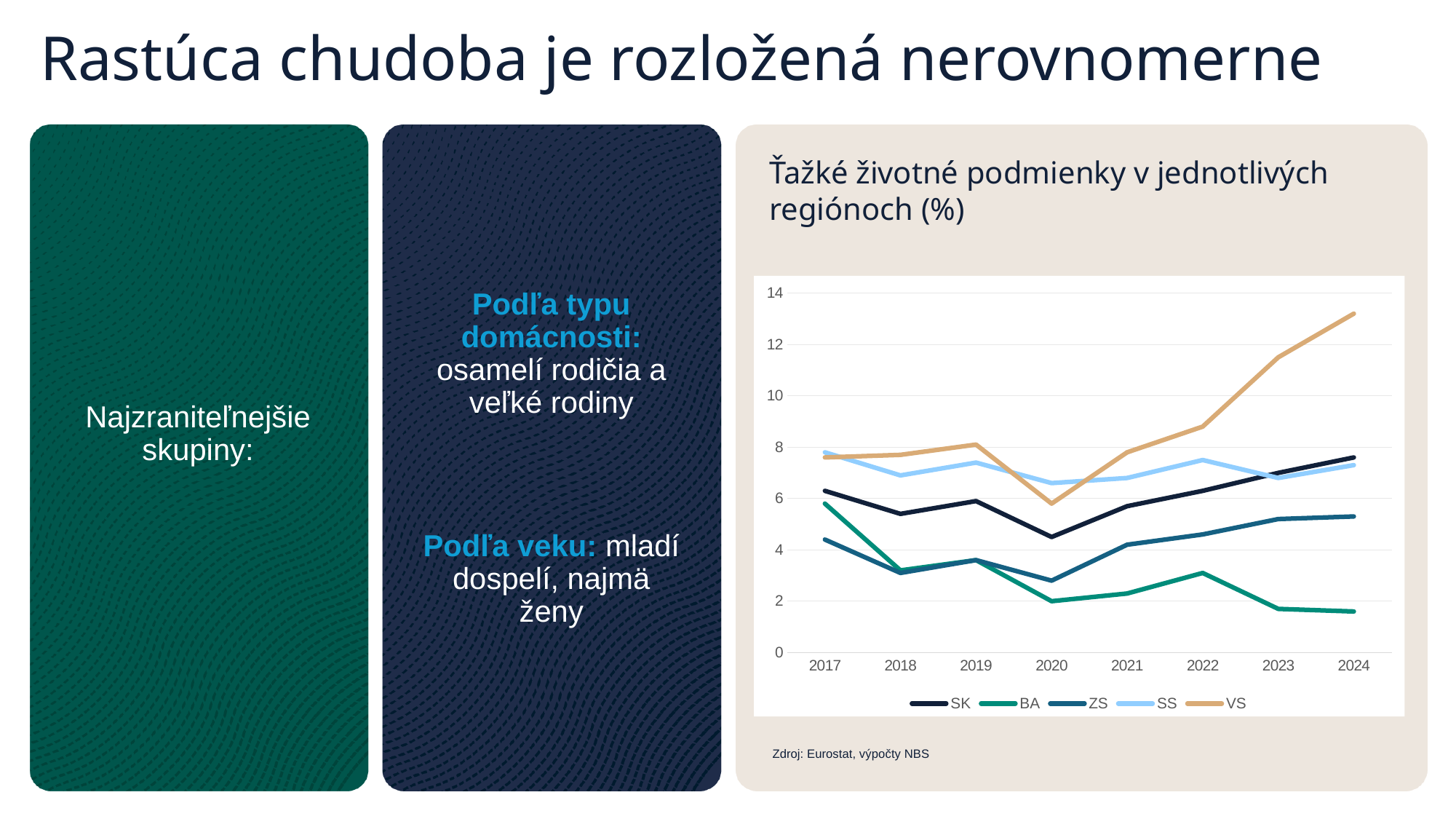
How many series does the legend of the chart list? 5 In 2024, which is larger: the value for SK or the value for ZS? SK Does the VS line rise or fall from 2020 to 2024? rises Is the value for VS in 2024 greater or less than 12? greater How many years are shown on the x axis of the chart? 8 What kind of chart is shown on the slide? line chart Which region has the lowest value in 2024? BA What is the title of the chart? Ťažké životné podmienky v jednotlivých regiónoch (%) Which region has the highest value in 2024? VS Does the BA line rise or fall from 2017 to 2024? falls Is the value for SK in 2020 greater or less than 6? less Is the value for BA in 2024 greater or less than 2? less